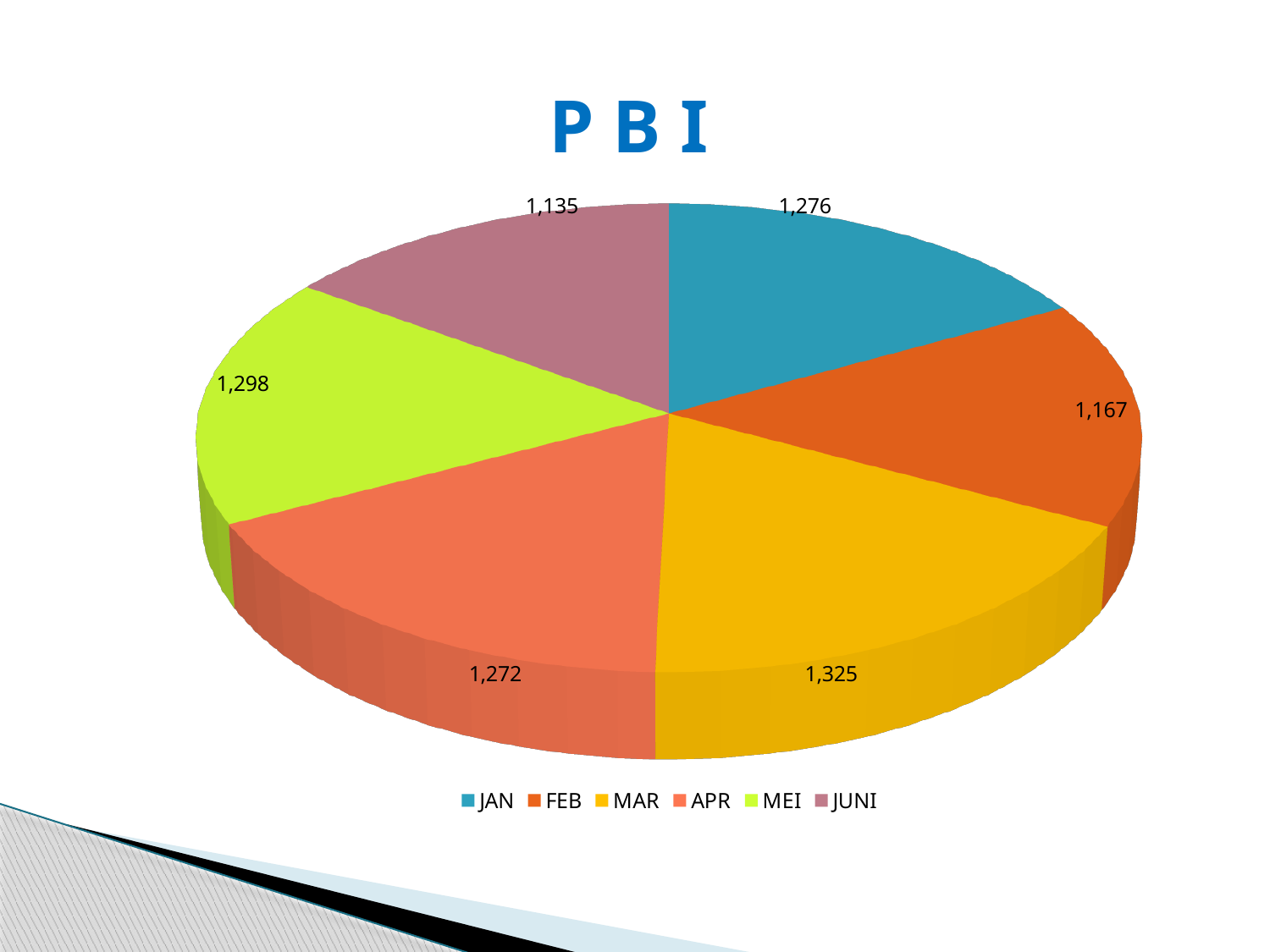
What type of chart is shown on the slide? Pie chart How many slices does the pie chart have? 6 Which month has the smallest slice? JUNI What is the value for MAR? 1,325 Which month has the largest slice? MAR What is the value for JUNI? 1,135 What is the difference between the values for MAR and JUNI? 190 What is the value for MEI? 1,298 What is the title of the chart? P B I Which is larger, the value for JAN or the value for APR? JAN What is the difference between the values for MEI and FEB? 131 Which colour represents FEB in the legend? Orange-red